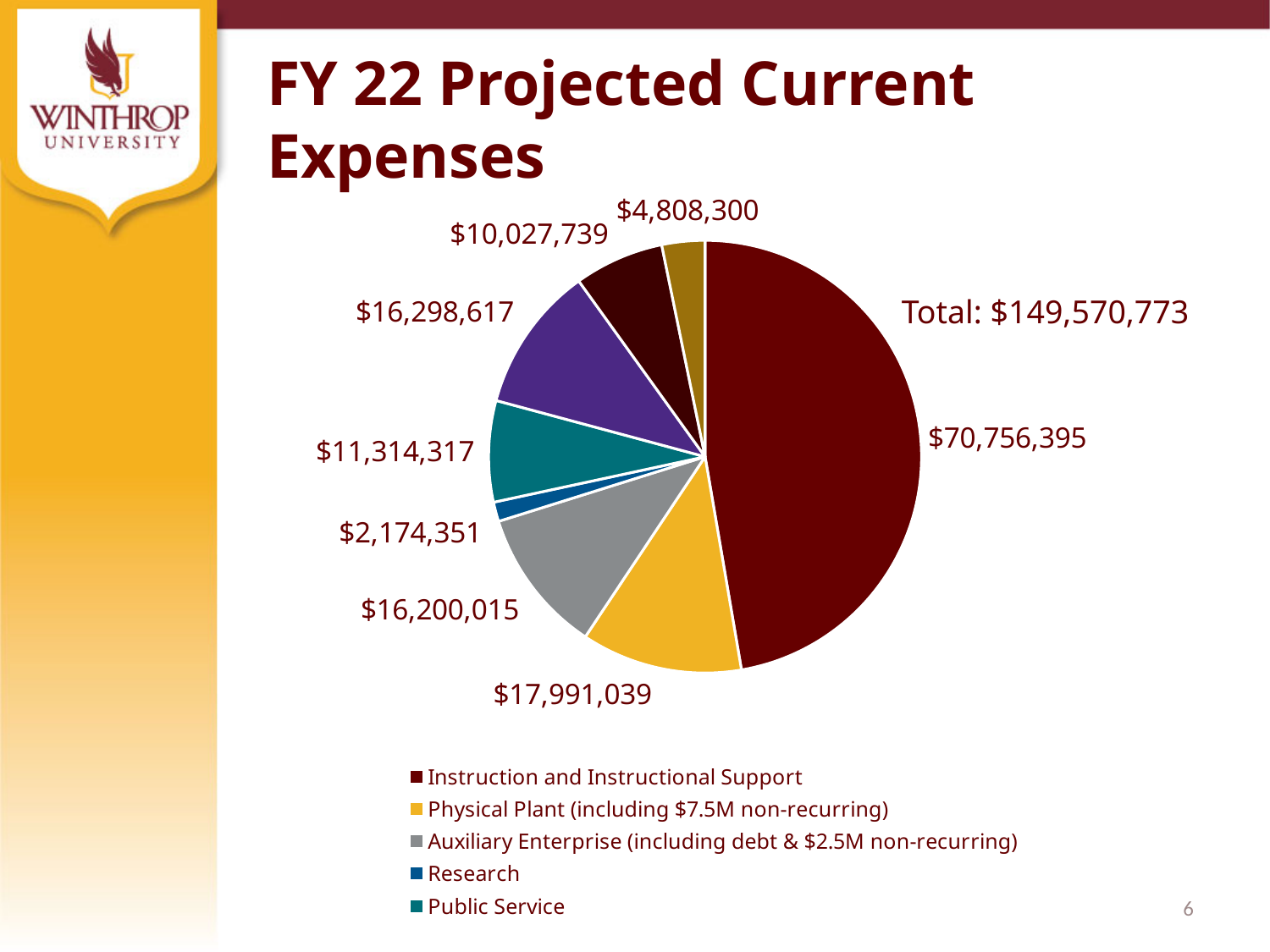
What is the value shown for Research? $2,174,351 How much larger is the Physical Plant value than the Auxiliary Enterprise value? $1,791,024 What is the value shown for Physical Plant (including $7.5M non-recurring)? $17,991,039 What is the value shown for Auxiliary Enterprise (including debt & $2.5M non-recurring)? $16,200,015 Which category has the smallest slice of the pie? Research What is the value shown for Public Service? $11,314,317 How much larger is the Instruction and Instructional Support value than the Physical Plant value? $52,765,356 Which category has the largest slice of the pie? Instruction and Instructional Support What is the projected FY 22 expense for Instruction and Instructional Support? $70,756,395 Which is larger, the value for Public Service or the value for Auxiliary Enterprise? Auxiliary Enterprise What kind of chart is shown on the slide? Pie chart What total is stated next to the pie chart? $149,570,773